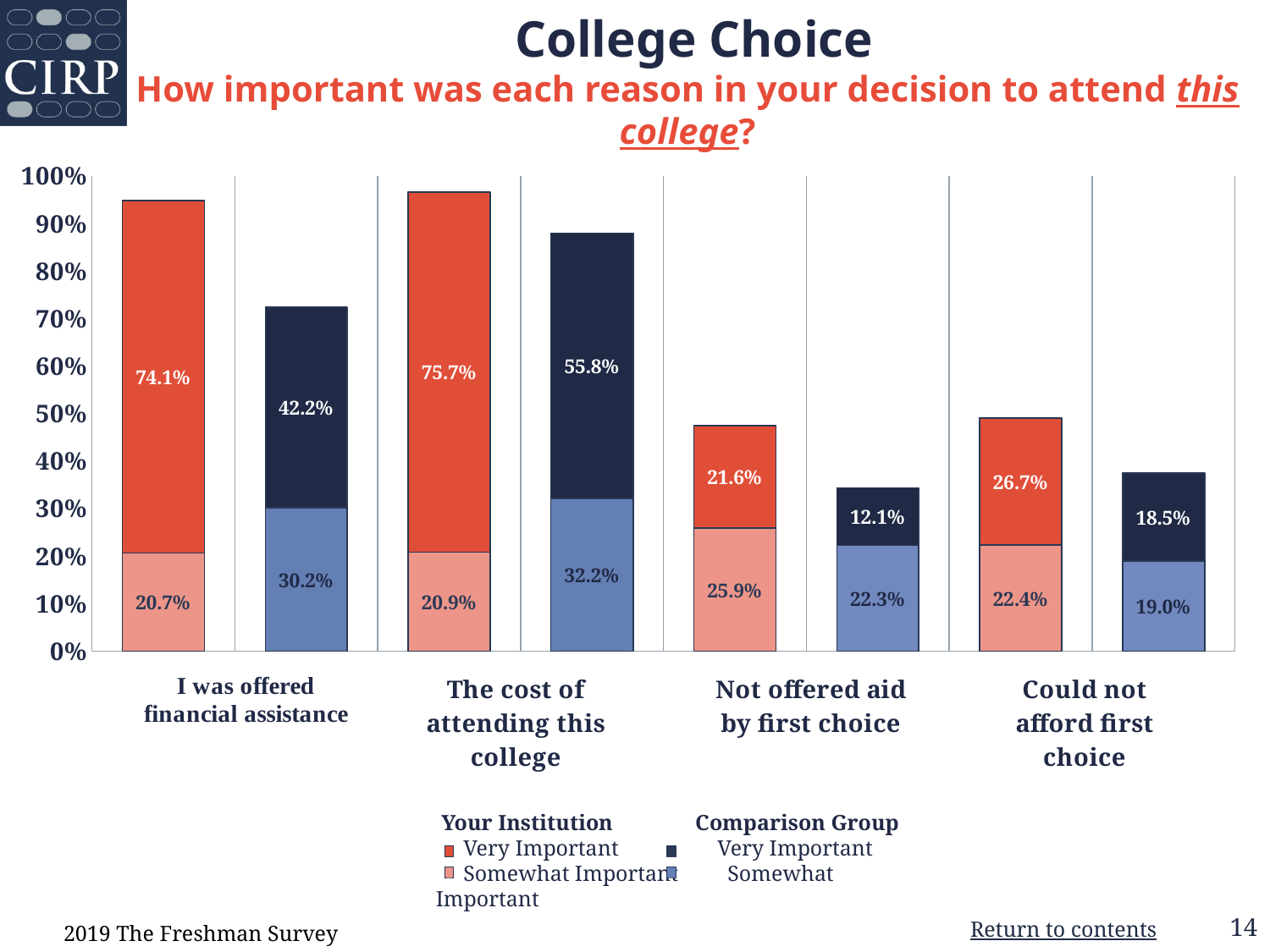
What is the difference between the Your Institution and Comparison Group Very Important percentages for "I was offered financial assistance"? 31.9% How many reasons (categories) are shown on the x axis of the chart? 4 Which reason has the highest Very Important percentage for Your Institution? The cost of attending this college Which reason has the lowest Very Important percentage for the Comparison Group? Not offered aid by first choice What is the total height of the Your Institution stacked bar for "Not offered aid by first choice"? 47.5% What percentage of students at Your Institution rated "Could not afford first choice" as Very Important? 26.7% What is the total height of the Comparison Group stacked bar for "The cost of attending this college"? 88.0% What percentage of students at Your Institution rated "I was offered financial assistance" as Very Important? 74.1% Which is larger: the Comparison Group Very Important percentage for "Could not afford first choice" or for "Not offered aid by first choice"? Could not afford first choice What percentage of the Comparison Group rated "The cost of attending this college" as Somewhat Important? 32.2% What kind of chart is shown on the slide? Stacked bar chart Is the total of the Your Institution stacked bar for "I was offered financial assistance" greater or less than 90%? greater